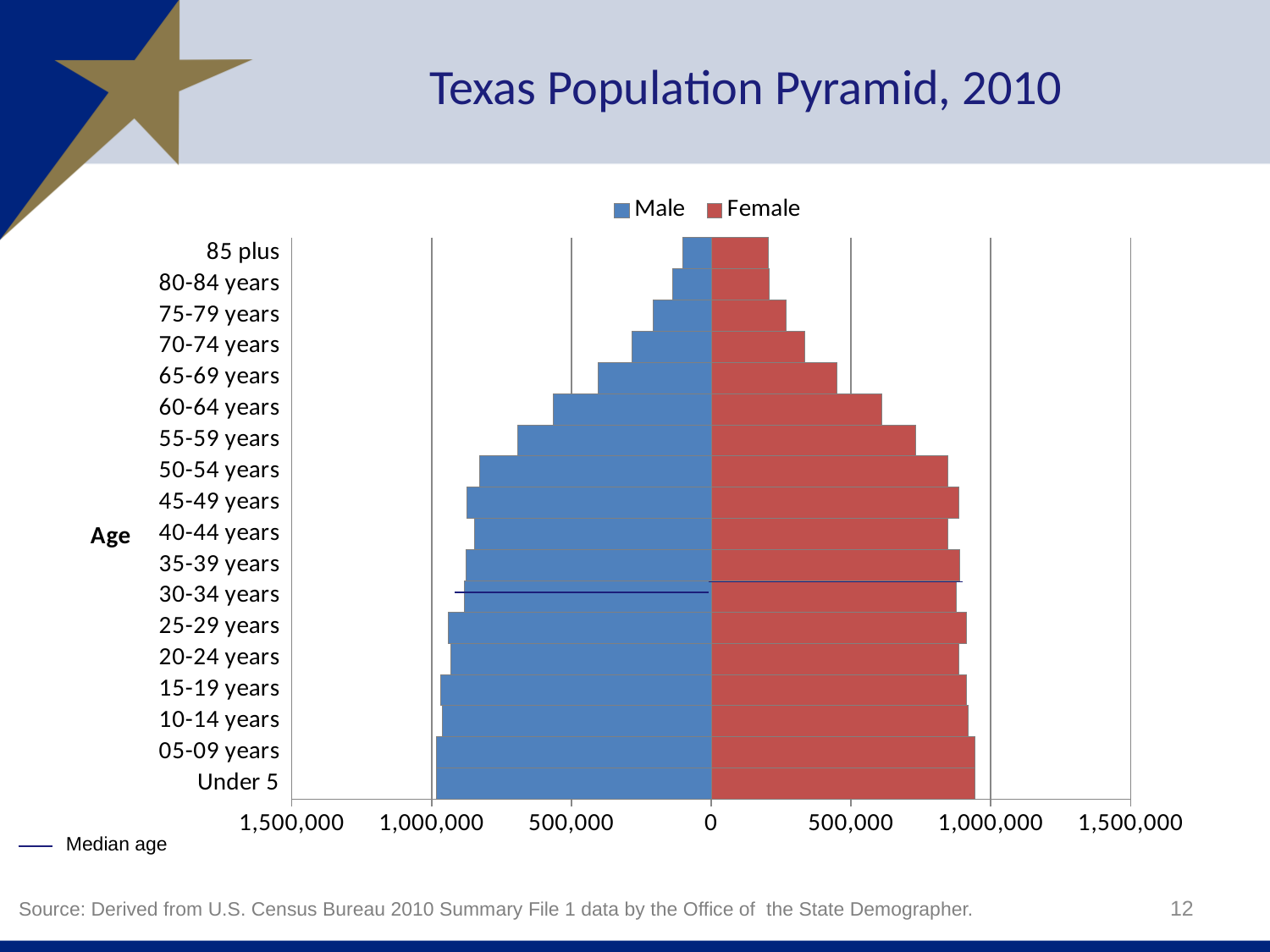
How many age groups are shown on the vertical axis? 18 Is the Female value for 45-49 years greater or less than 500,000? greater Which age group has the smallest Male value? 85 plus What kind of chart is shown on the slide? Bar chart For the 85 plus age group, which is larger, the Male value or the Female value? Female Do the bar lengths generally increase or decrease moving from the oldest age group (85 plus) down to the youngest (Under 5)? Increase How many series does the legend list? 2 Is the Female value for 55-59 years greater or less than 500,000? greater Is the Male value for 65-69 years greater or less than 500,000? less Which is larger, the Male value for 50-54 years or the Male value for 65-69 years? 50-54 years What colour represents the Male series? Blue